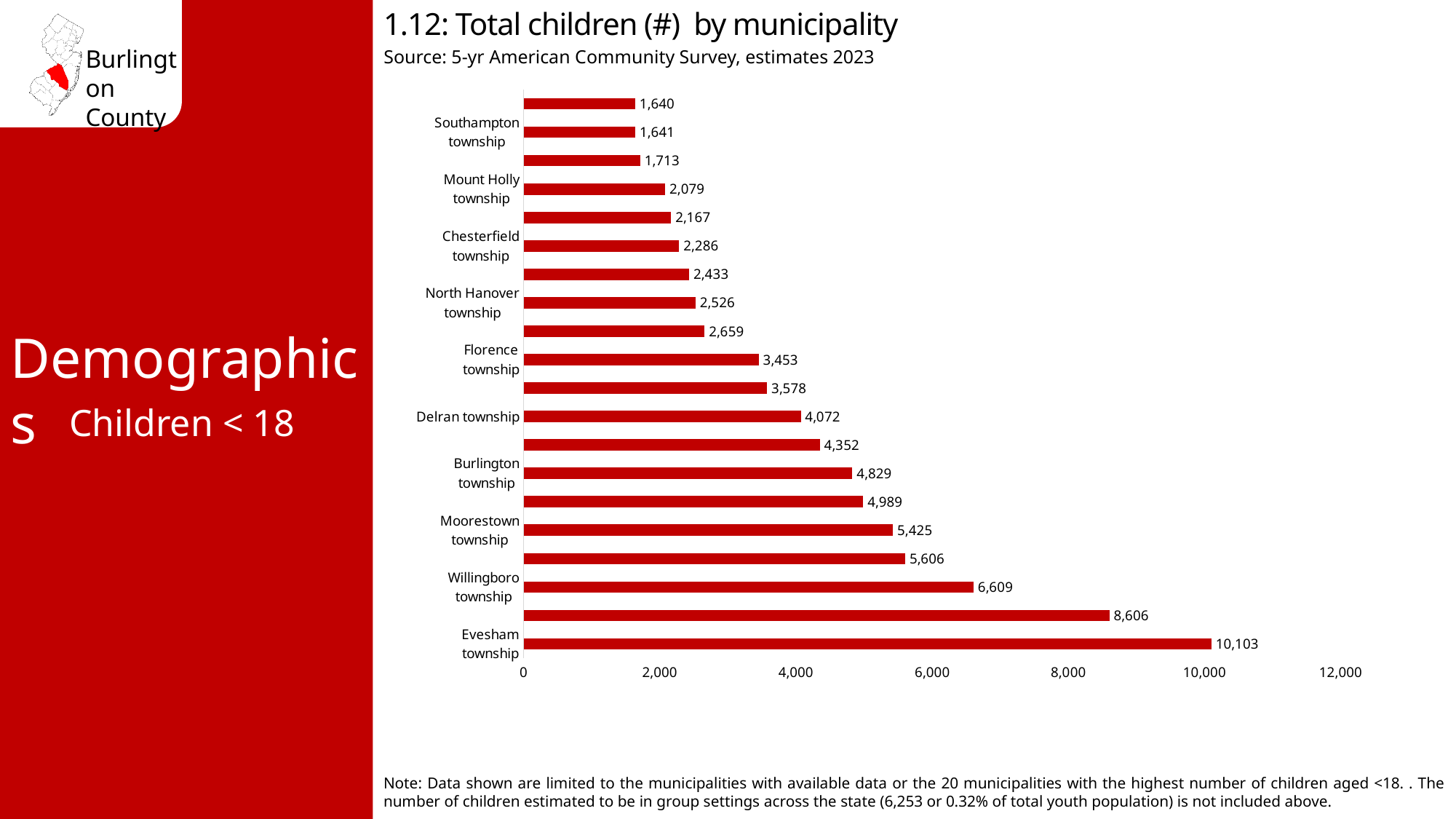
What is the difference between the values for Delran township and Florence township? 619 Which municipality has the highest number of children? Evesham township What is the value for Delran township? 4,072 Is the value for Moorestown township greater or less than 4,000? greater What is the value for Mount Holly township? 2,079 What is the value for Evesham township? 10,103 What is the value for Willingboro township? 6,609 What is the difference between the values for Evesham township and Willingboro township? 3,494 How many bars are plotted in the chart? 20 Which is larger, the value for Burlington township or Delran township? Burlington township What kind of chart is shown on the slide? bar chart What is the value for Moorestown township? 5,425